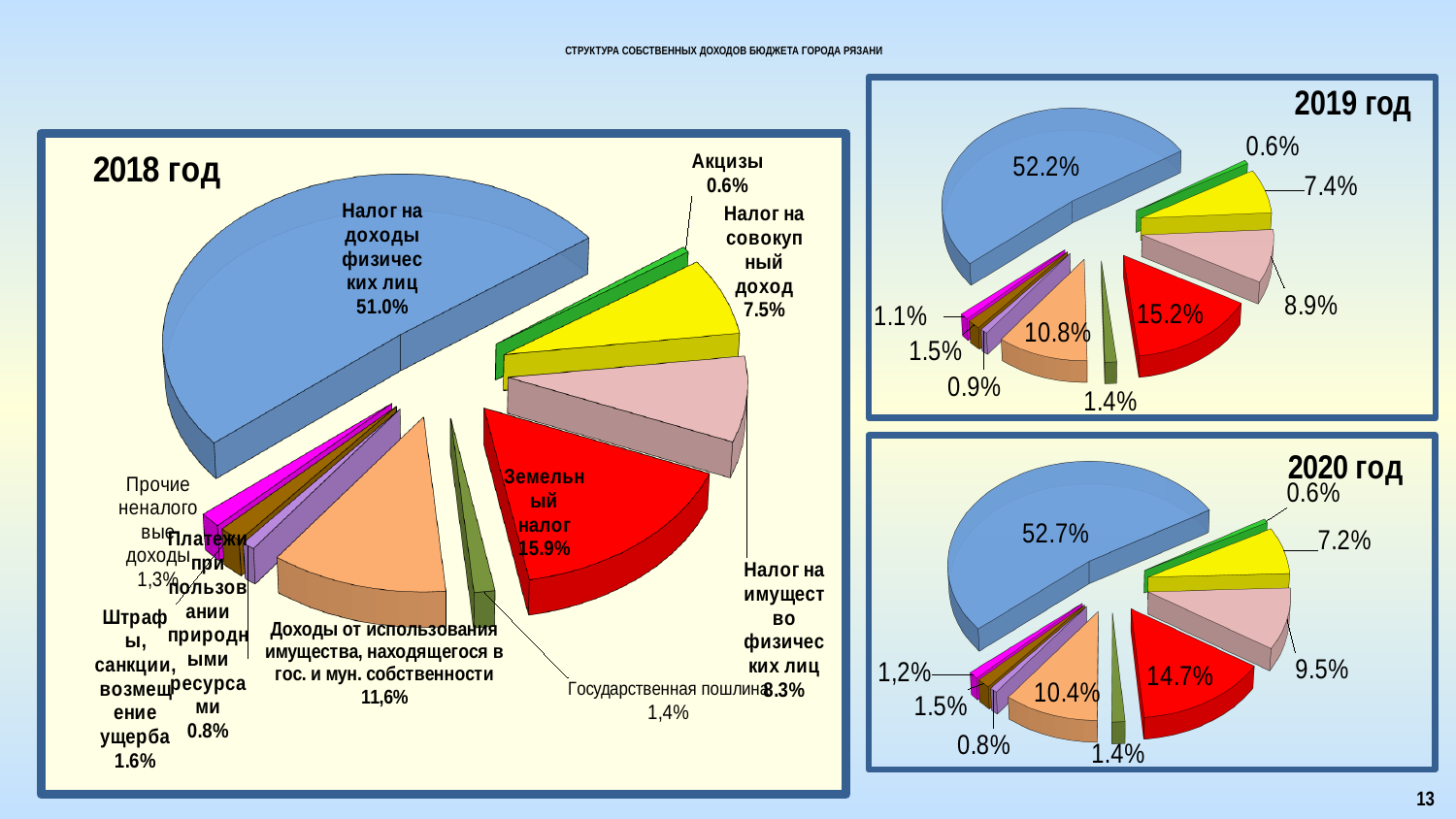
In the 2018 год chart, what is the difference between the shares of Земельный налог and Налог на имущество физических лиц? 7.6% In the 2018 год chart, which is larger: Налог на совокупный доход or Налог на имущество физических лиц? Налог на имущество физических лиц In the 2019 год chart, what is the largest slice's value? 52.2% In the 2018 год chart, what share is shown for Налог на доходы физических лиц? 51.0% In the 2018 год chart, what share is shown for Земельный налог? 15.9% What is the title at the top of the slide? СТРУКТУРА СОБСТВЕННЫХ ДОХОДОВ БЮДЖЕТА ГОРОДА РЯЗАНИ In the 2018 год chart, what share is shown for Государственная пошлина? 1,4% In the 2018 год chart, what share is shown for Доходы от использования имущества, находящегося в гос. и мун. собственности? 11,6% What type of chart is used for the 2020 год data? Pie chart In the 2020 год chart, what is the smallest slice's value? 0.6% In the 2018 год chart, what share is shown for Акцизы? 0.6% How many slices does the 2018 год pie chart have? 10